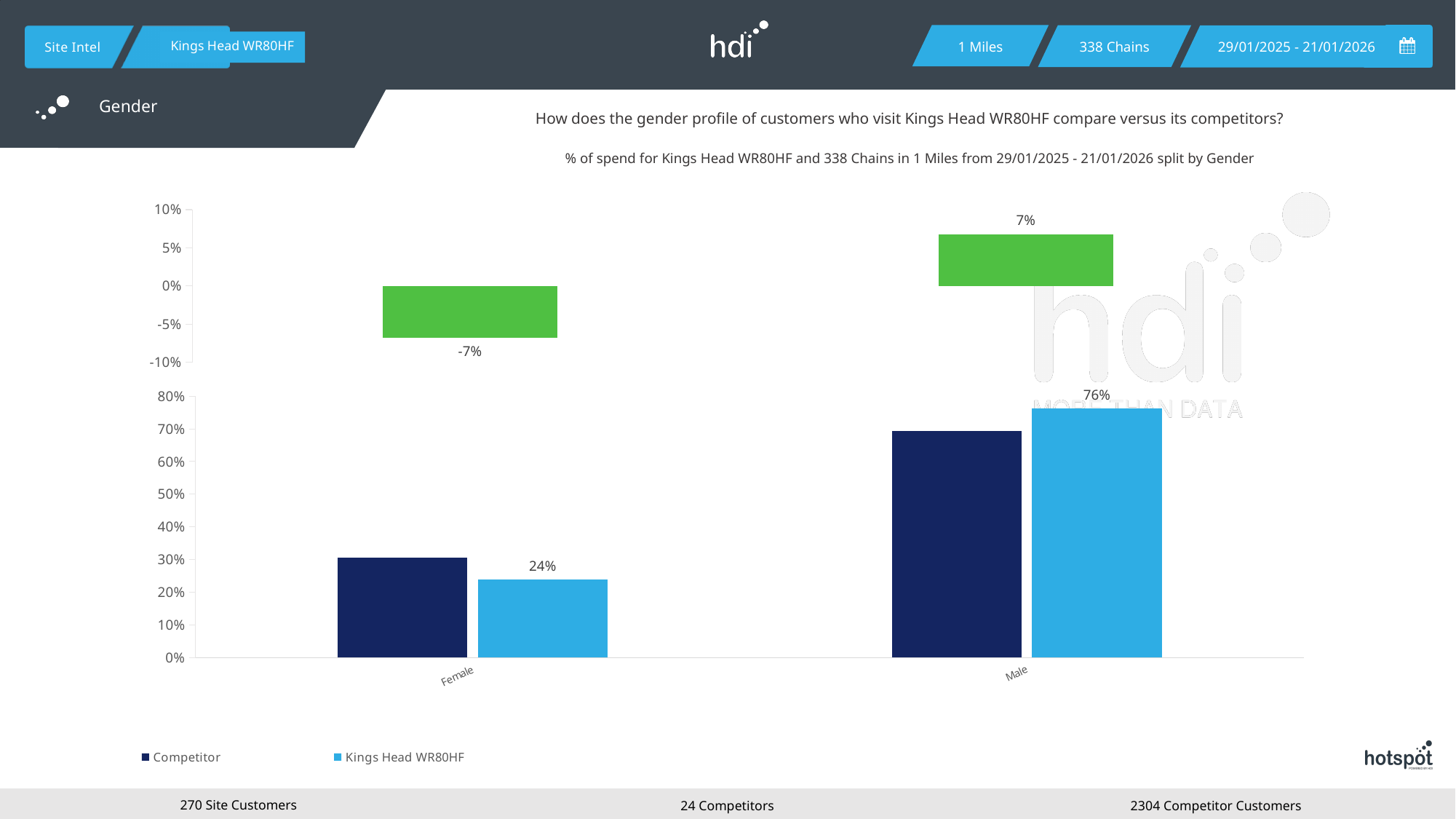
In the bottom bar chart, is the Competitor value for Male greater or less than 60%? greater In the top chart, what is the value shown for the Male category? 7% In the bottom bar chart, what is the value for Kings Head WR80HF in the Male category? 76% In the bottom bar chart, which is larger in the Male category: Competitor or Kings Head WR80HF? Kings Head WR80HF What kind of chart is the bottom chart? bar chart In the bottom bar chart, what is the difference between the Kings Head WR80HF values for Male and Female? 52% In the bottom bar chart, is the Competitor value for Female greater or less than 40%? less In the top chart, what is the value shown for the Female category? -7% In the bottom bar chart, what is the value for Kings Head WR80HF in the Female category? 24% How many categories are shown on the x axis of the bottom bar chart? 2 In the bottom bar chart, which category has the highest value for Kings Head WR80HF? Male How many series does the legend of the bottom bar chart list? 2